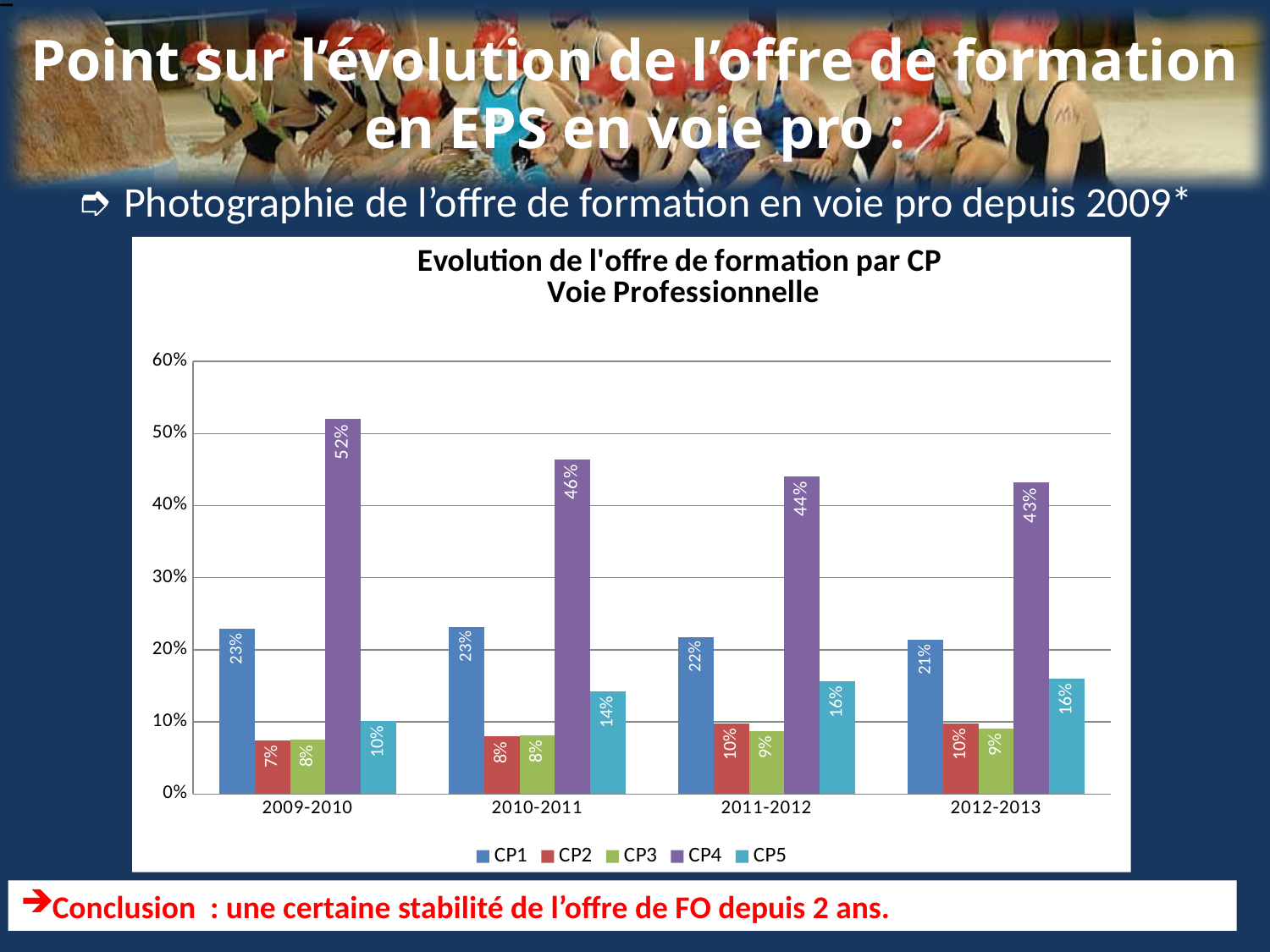
What is the difference between the CP4 values for 2009-2010 and 2012-2013? 9% What kind of chart is shown on the slide? Bar chart Which series has the lowest value in 2009-2010? CP2 What is the value for CP1 in 2012-2013? 21% Do the CP4 values rise or fall from 2009-2010 to 2012-2013? Fall Which is larger, CP1 in 2011-2012 or CP5 in 2011-2012? CP1 in 2011-2012 What is the value for CP4 in 2009-2010? 52% What is the value for CP5 in 2011-2012? 16% Is the value for CP4 in 2011-2012 greater or less than 40%? greater How many series does the legend list? 5 Which series has the highest value in 2010-2011? CP4 How many year categories are shown on the x axis? 4